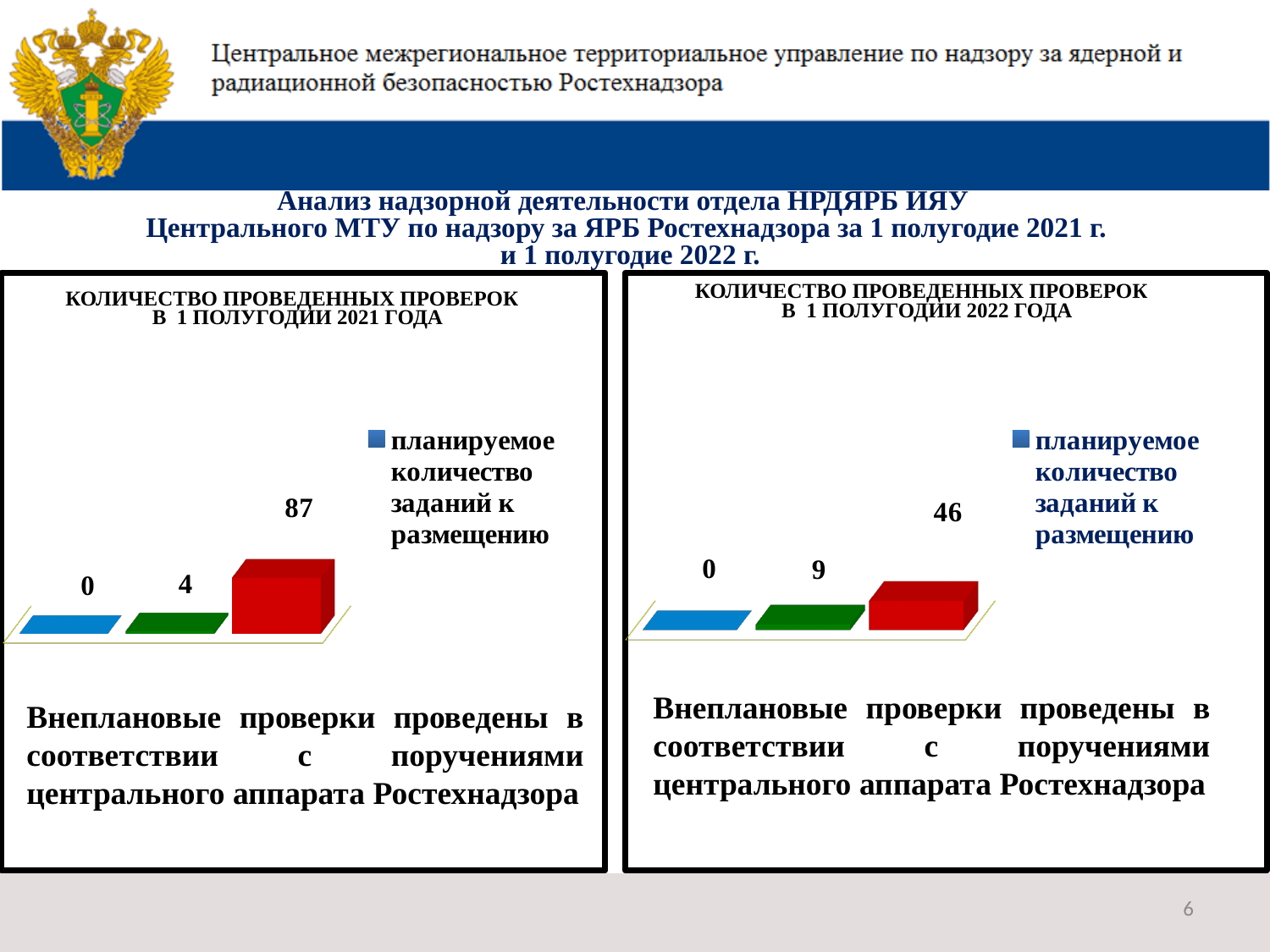
In the left chart (1 полугодие 2021 года), what is the highest value shown? 87 In the right chart (1 полугодие 2022 года), what is the difference between the red bar (46) and the green bar (9)? 37 In the right chart (1 полугодие 2022 года), what is the lowest value shown? 0 Which is larger: the red bar in the 2021 chart or the red bar in the 2022 chart? The red bar in the 2021 chart (87) How many bars are plotted in the chart titled "КОЛИЧЕСТВО ПРОВЕДЕННЫХ ПРОВЕРОК В 1 ПОЛУГОДИИ 2022 ГОДА"? 3 In the chart titled "КОЛИЧЕСТВО ПРОВЕДЕННЫХ ПРОВЕРОК В 1 ПОЛУГОДИИ 2021 ГОДА", what is the value of the tallest (red) bar? 87 What type of chart is used in the left chart (1 полугодие 2021 года)? Bar chart In the left chart (1 полугодие 2021 года), what value is shown for the green bar? 4 In the chart titled "КОЛИЧЕСТВО ПРОВЕДЕННЫХ ПРОВЕРОК В 1 ПОЛУГОДИИ 2022 ГОДА", what is the value of the tallest (red) bar? 46 In the right chart (1 полугодие 2022 года), what value is shown for the green bar? 9 In the left chart (1 полугодие 2021 года), what is the difference between the red bar (87) and the green bar (4)? 83